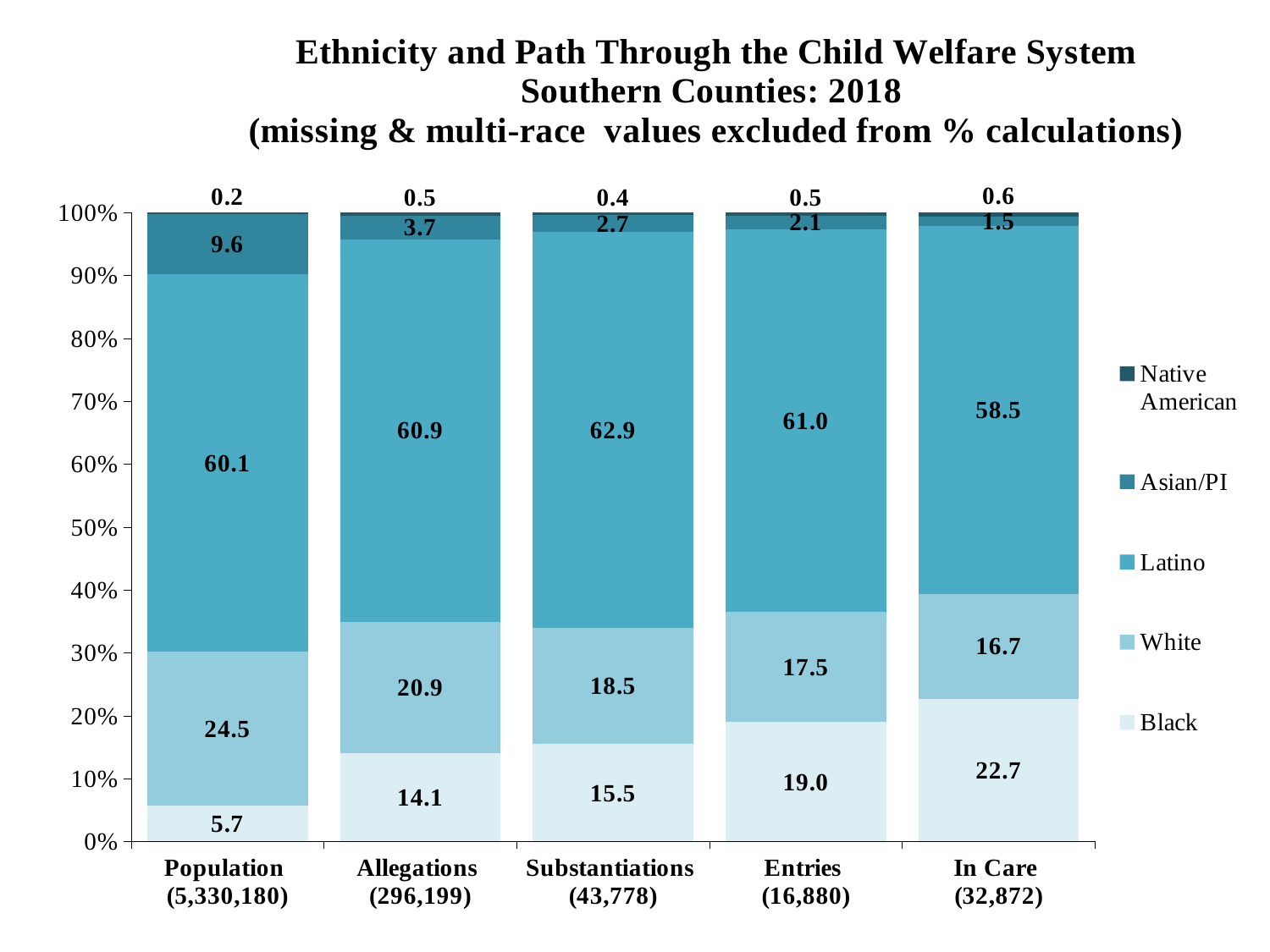
What is the Native American value for In Care? 0.6 How many categories are shown on the x axis? 5 What kind of chart is shown on the slide? Stacked bar chart What is the Black value for Population? 5.7 Which category has the lowest White value? In Care How many series does the legend list? 5 Which category has the highest Black value? In Care What is the difference between the Black value for In Care and the Black value for Population? 17.0 What is the Latino value for Substantiations? 62.9 What is the Asian/PI value for Allegations? 3.7 Which is larger, the White value for Allegations or the White value for Entries? Allegations Do the Black values rise or fall from Population to In Care along the x axis? Rise